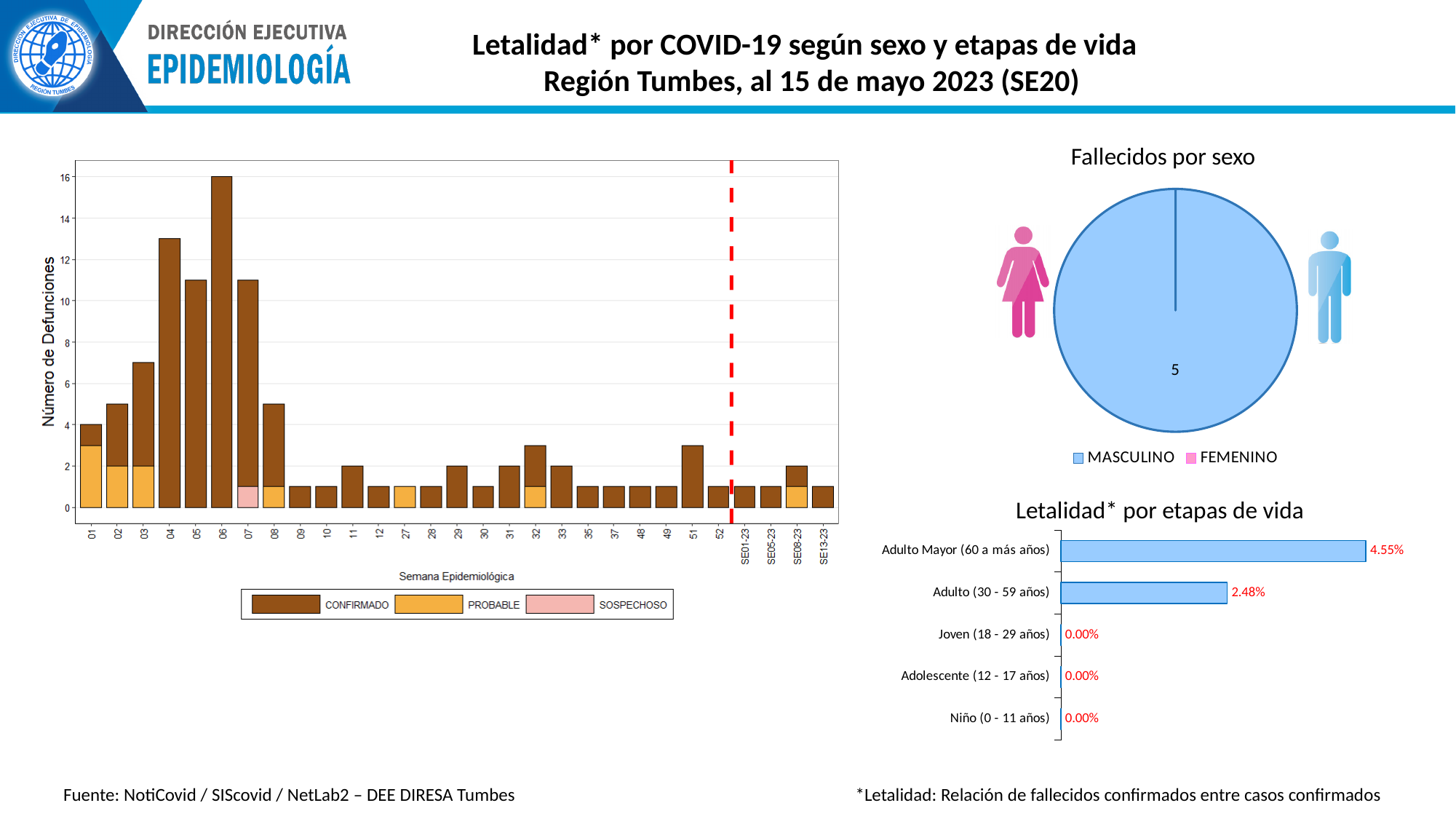
In the 'Letalidad* por etapas de vida' chart, what is the value for Joven (18 - 29 años)? 0.00% How many series does the legend of the 'Fallecidos por sexo' chart list? 2 In the 'Letalidad* por etapas de vida' chart, how many age groups are shown? 5 In the 'Letalidad* por etapas de vida' chart, what is the value for Adulto (30 - 59 años)? 2.48% In the stacked bar chart on the left, what is the total number of deaths for week 06? 16 In the 'Fallecidos por sexo' pie chart, what value is shown for MASCULINO? 5 What kind of chart is 'Fallecidos por sexo'? Pie chart In the 'Letalidad* por etapas de vida' chart, what is the difference between the values for Adulto Mayor (60 a más años) and Adulto (30 - 59 años)? 2.07% In the 'Letalidad* por etapas de vida' chart, which age group has the highest value? Adulto Mayor (60 a más años) How many series does the legend of the stacked bar chart on the left list? 3 In the 'Letalidad* por etapas de vida' chart, what is the value for Adulto Mayor (60 a más años)? 4.55% In the stacked bar chart on the left, which epidemiological week has the highest number of deaths? 06